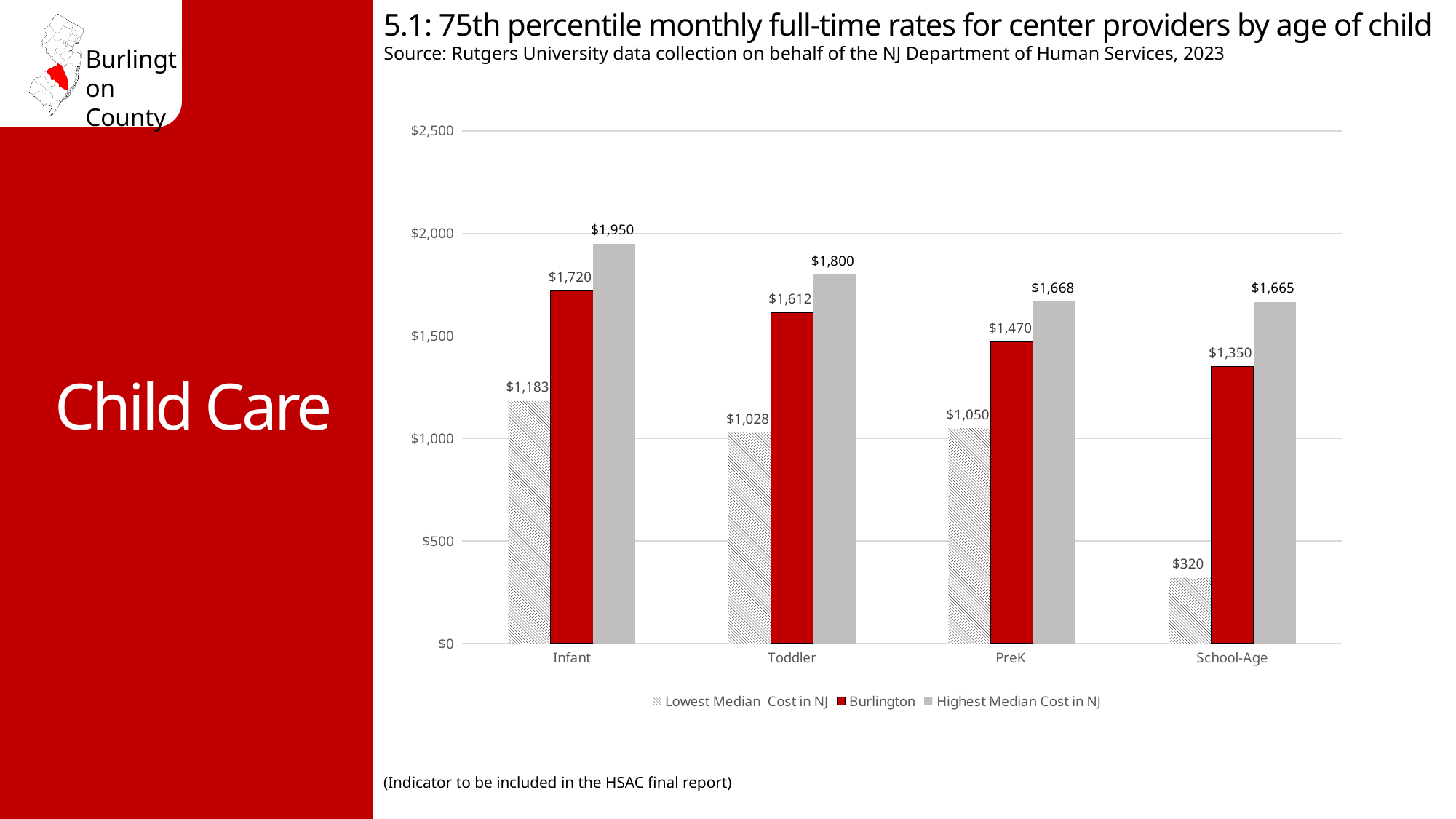
How many age categories are shown on the x axis? 4 Which is larger for Toddler: the Burlington value or the Lowest Median Cost in NJ? Burlington What is the difference between the Highest Median Cost in NJ and the Burlington value for PreK? $198 Which age category has the highest Burlington value? Infant What is the Lowest Median Cost in NJ for School-Age? $320 What is the Burlington value for Infant? $1,720 Is the Burlington value for School-Age greater or less than $1,500? less Which age category has the lowest Lowest Median Cost in NJ value? School-Age Do the Burlington values rise or fall from Infant to School-Age? fall What kind of chart is shown on the slide? bar chart How many series does the legend list? 3 What is the Highest Median Cost in NJ for Toddler? $1,800